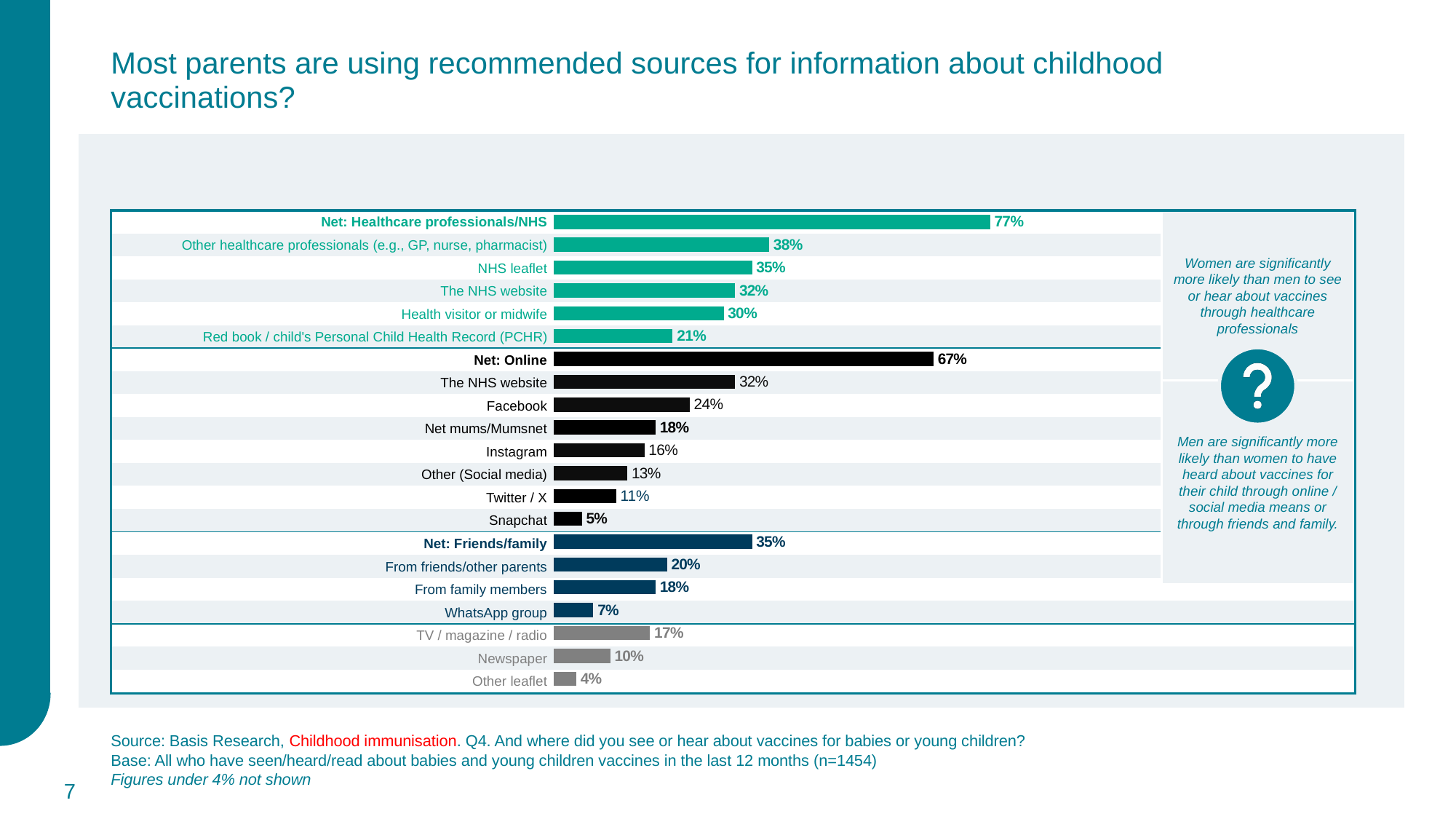
What is the value for Facebook? 24% Which is larger, the value for Newspaper or the value for TV / magazine / radio? TV / magazine / radio What is the value for Red book / child's Personal Child Health Record (PCHR)? 21% What is the value for WhatsApp group? 7% Which is larger, the value for NHS leaflet or the value for Health visitor or midwife? NHS leaflet Which category has the lowest value in the chart? Other leaflet What kind of chart is shown on the slide? bar chart What is the value for Net: Healthcare professionals/NHS? 77% Which category has the highest value in the chart? Net: Healthcare professionals/NHS What is the difference between the values for Facebook and Instagram? 8% How many bars are plotted in the chart? 21 What is the difference between the values for Net: Healthcare professionals/NHS and Net: Online? 10%